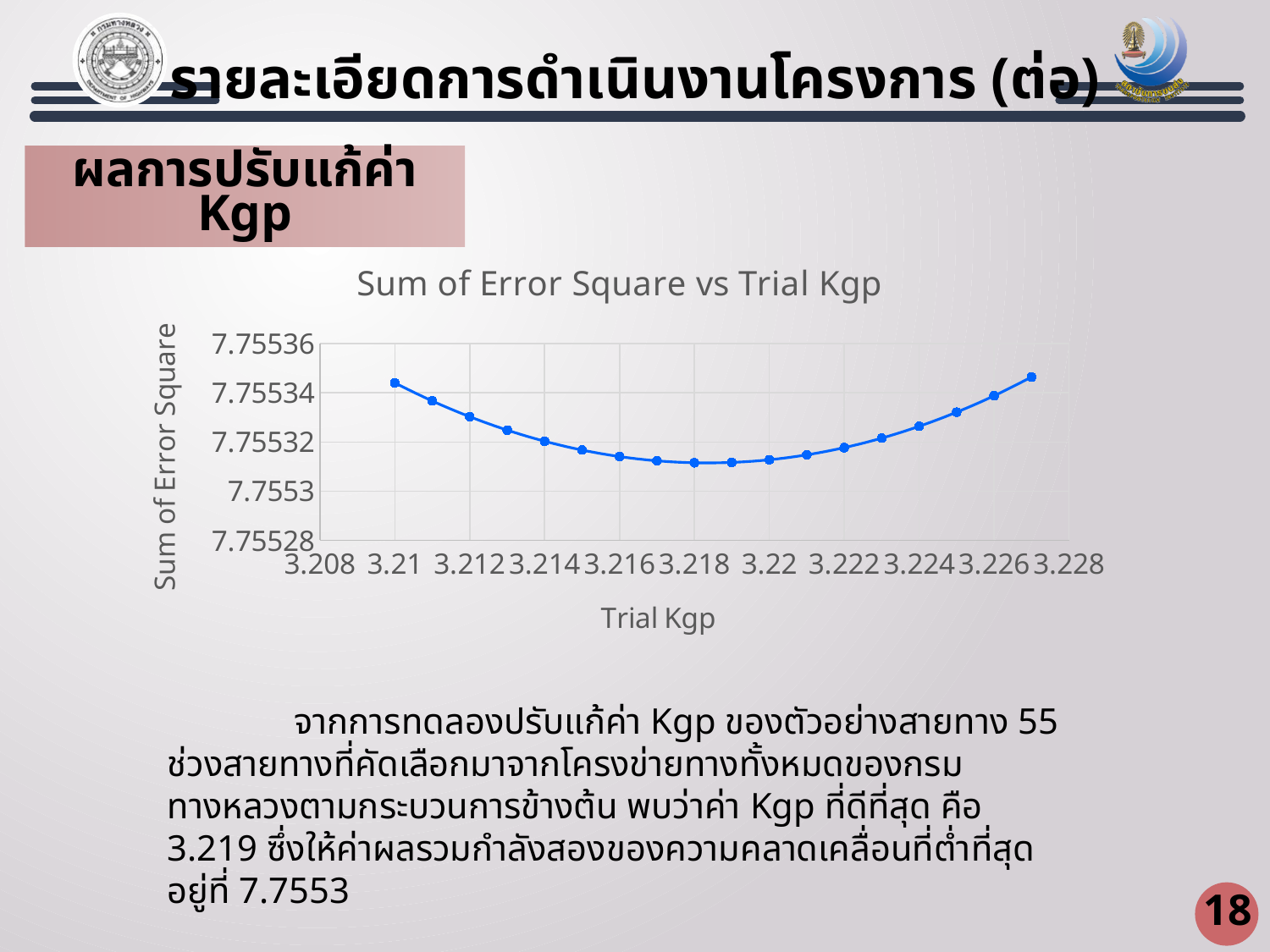
What is the highest value shown on the y axis of the chart? 7.75536 How many data points are plotted on the chart? 18 Is the Sum of Error Square at Trial Kgp 3.227 greater or less than 7.75532? greater Is the Sum of Error Square at Trial Kgp 3.21 greater or less than 7.75532? greater What is the label of the x axis of the chart? Trial Kgp How does the Sum of Error Square change as Trial Kgp increases from 3.21 to 3.227? It falls, then rises What type of chart is shown on the slide? Line chart Which has a higher Sum of Error Square: Trial Kgp 3.219 or Trial Kgp 3.226? 3.226 What is the title of the chart? Sum of Error Square vs Trial Kgp Is the Sum of Error Square at Trial Kgp 3.214 greater or less than 7.75534? less Which has a higher Sum of Error Square: Trial Kgp 3.21 or Trial Kgp 3.218? 3.21